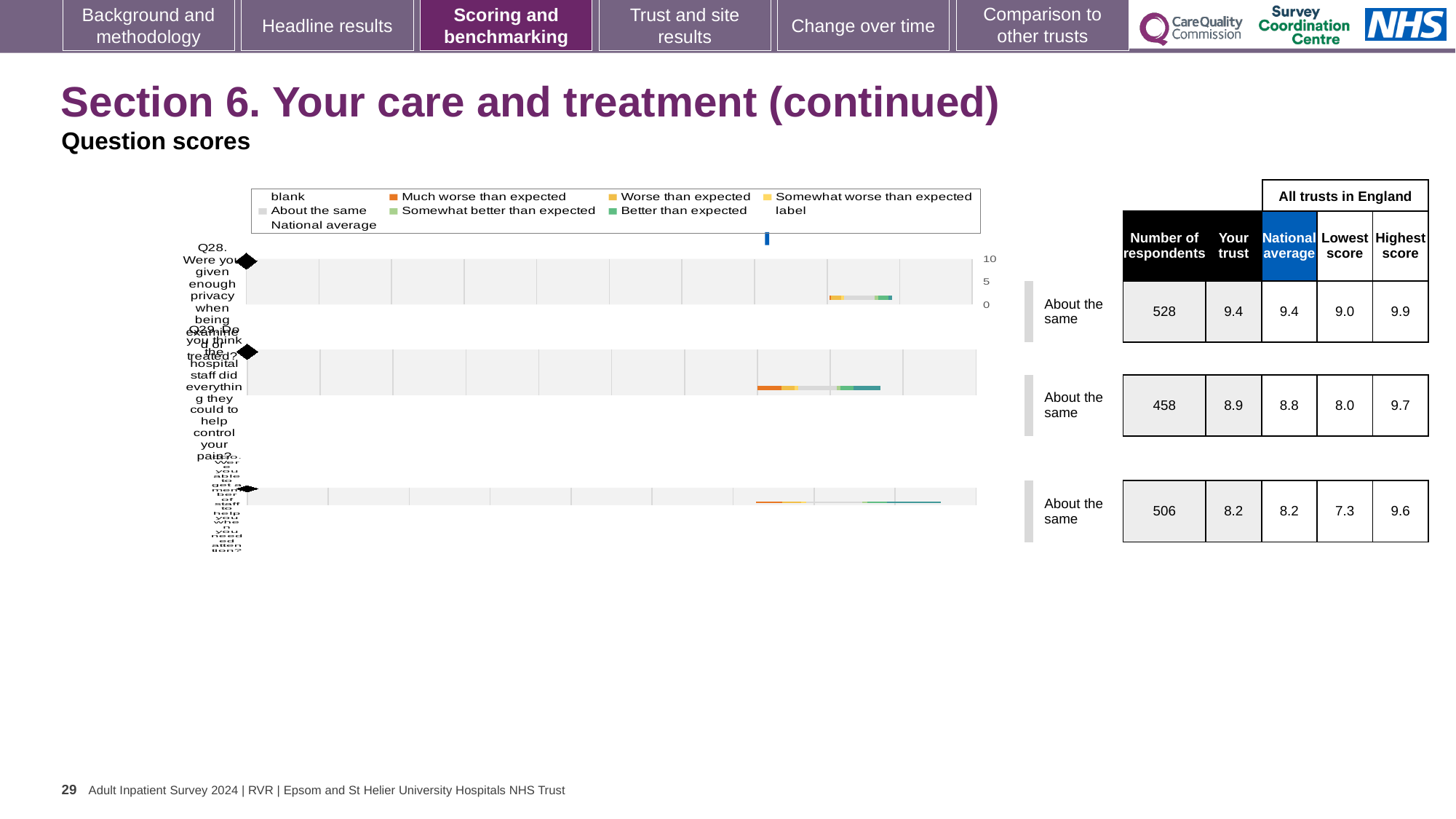
For Q29 (Do you think the hospital staff did everything they could to help control your pain?), what is the national average score? 8.8 Which question has more respondents, Q28 or Q30? Q28 Is the 'Your trust' score for Q28 greater or less than 5 on the chart axis? greater For Q28 (Were you given enough privacy when being examined or treated?), what is the 'Your trust' score? 9.4 For the third chart (Q30), what is the lowest score among all trusts in England? 7.3 Which question has the highest 'Your trust' score? Q28 Which question has the lowest 'Your trust' score? Q30 For Q28, what is the difference between the highest score and the lowest score among all trusts in England? 0.9 What benchmark label is shown next to each of the three charts? About the same What kind of chart is used to show the question scores on this slide? bar chart For Q29, what is the difference between the 'Your trust' score and the national average? 0.1 How many questions (charts) are shown on the slide? 3